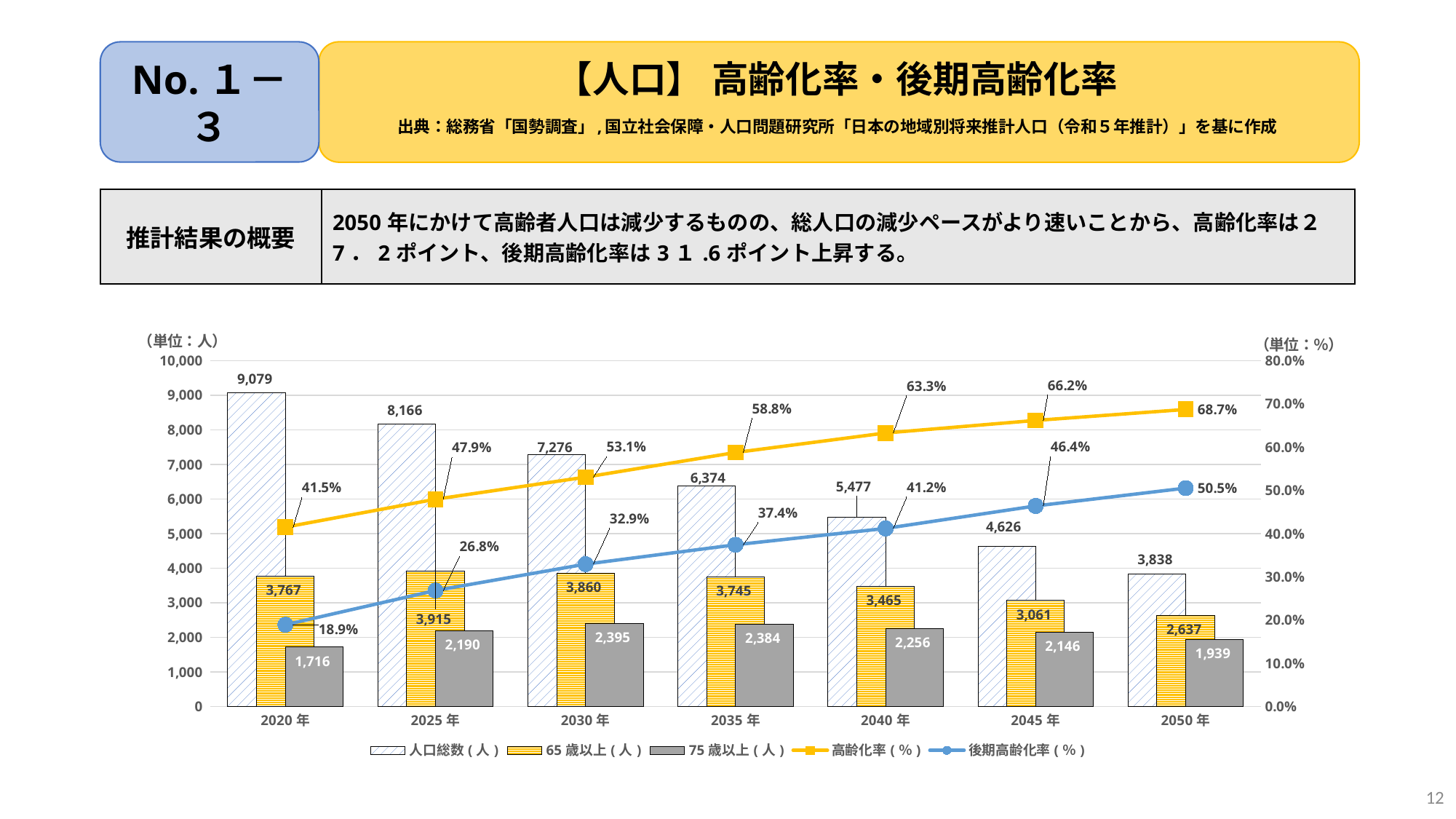
What is the difference between the 人口総数 (人) values for 2020年 and 2050年? 5,241 What is the 後期高齢化率 (%) for 2035年? 37.4% How many years are shown on the x axis? 7 In which year is the 65歳以上 (人) value highest? 2025年 What kind of chart is shown on the slide? Combined bar and line chart Does the 高齢化率 (%) line rise or fall from 2020年 to 2050年? rise In which year is the 75歳以上 (人) value lowest? 2020年 How many series does the legend list? 5 What is the 高齢化率 (%) for 2050年? 68.7% What is the value of 75歳以上 (人) for 2030年? 2,395 Which is larger: the 65歳以上 (人) value for 2040年 or for 2045年? 2040年 What is the value of 人口総数 (人) for 2020年? 9,079